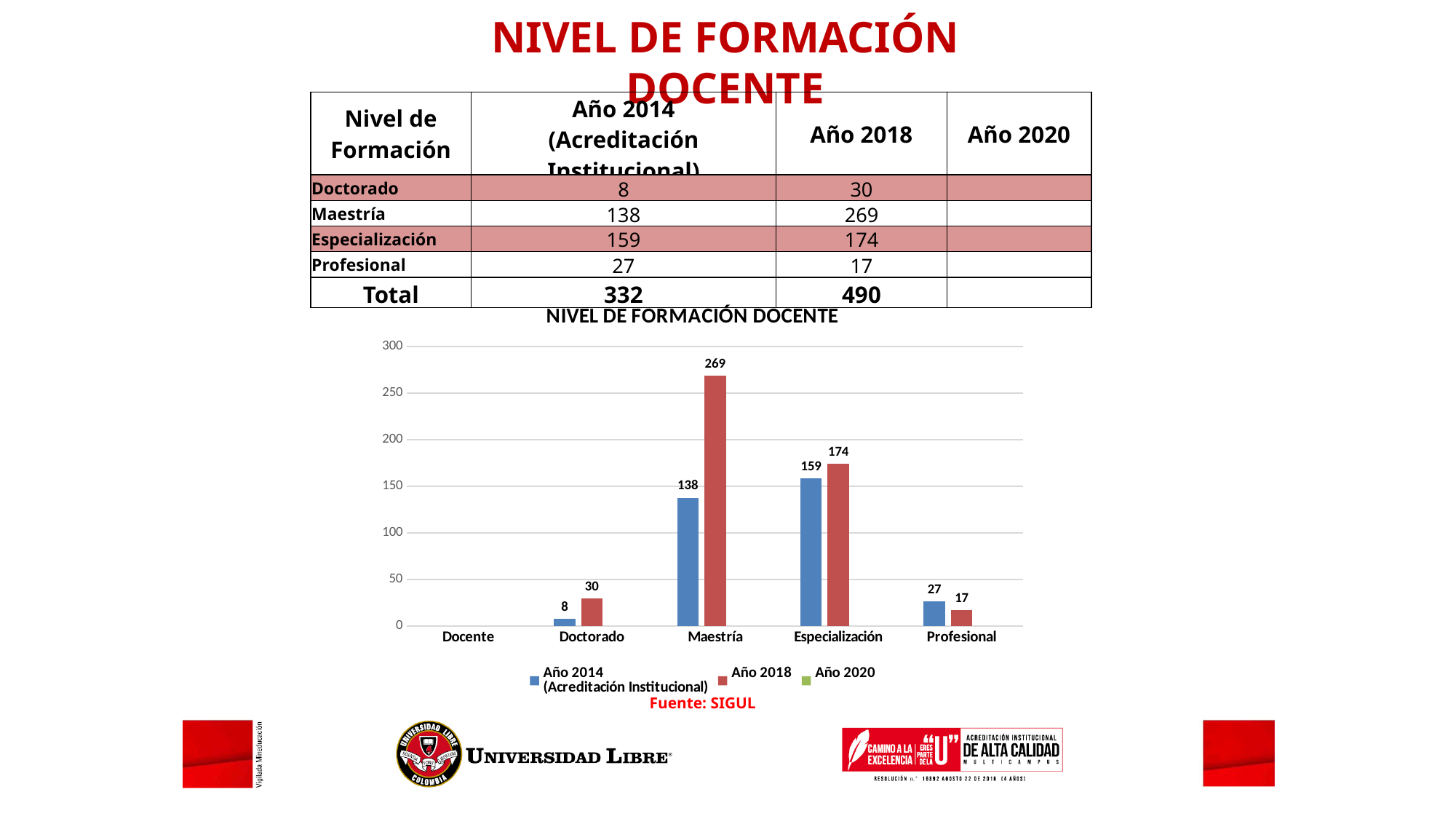
Which category has the highest value in the Año 2018 series? Maestría For Profesional, which series has the larger value, Año 2014 (Acreditación Institucional) or Año 2018? Año 2014 (Acreditación Institucional) What is the value for Profesional in the Año 2014 (Acreditación Institucional) series? 27 What colour are the Año 2018 bars in the chart? Red What is the value for Doctorado in the Año 2018 series? 30 What is the value for Maestría in the Año 2018 series? 269 What kind of chart is shown on the slide? Bar chart What is the title of the chart? NIVEL DE FORMACIÓN DOCENTE What is the difference between the Año 2018 and Año 2014 (Acreditación Institucional) values for Maestría? 131 How many series does the legend list? 3 Which category has the lowest value in the Año 2014 (Acreditación Institucional) series? Doctorado What is the value for Especialización in the Año 2014 (Acreditación Institucional) series? 159